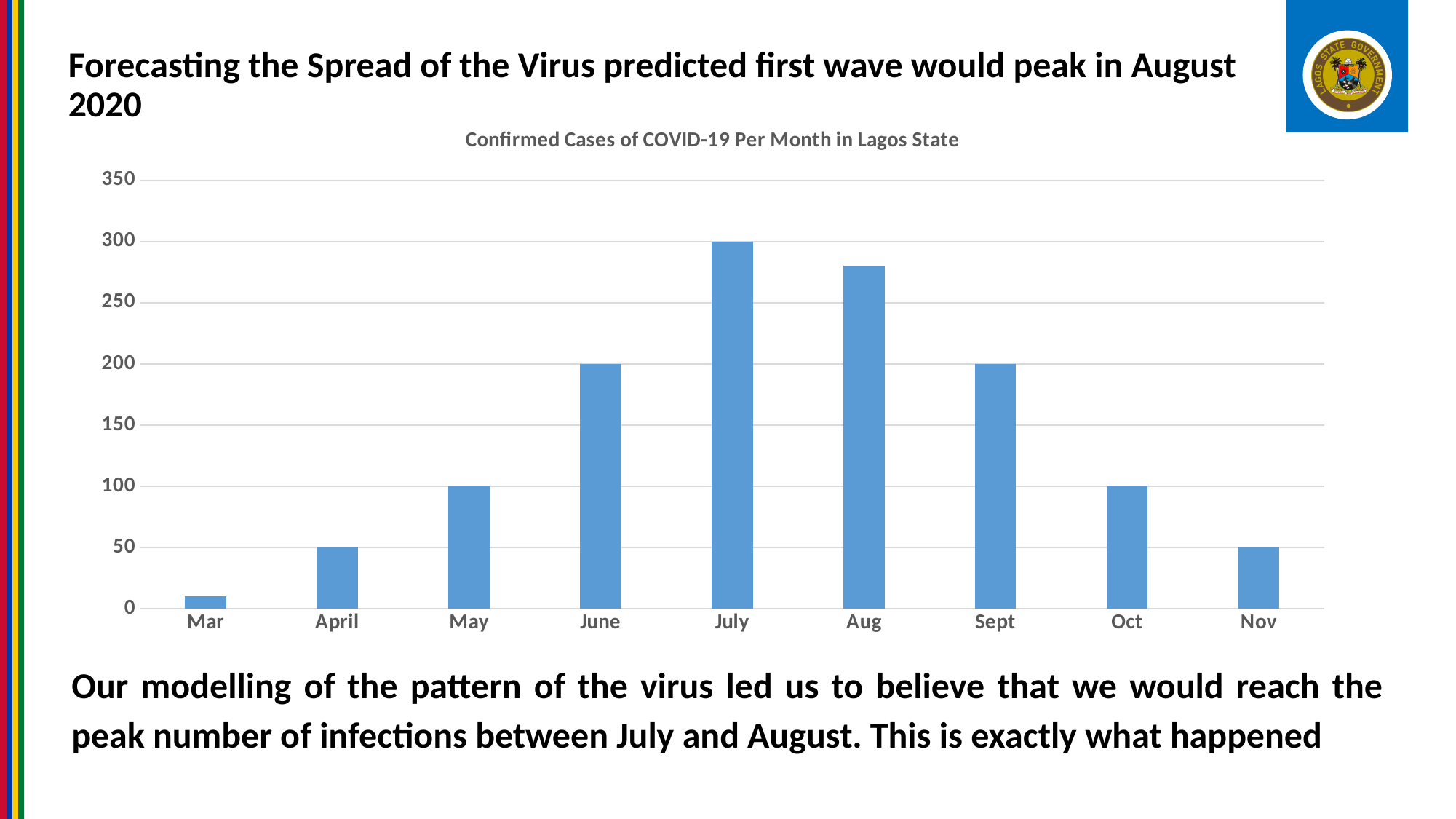
What is the value for Nov? 50 Which month has the lowest number of confirmed cases? Mar What is the title of the chart? Confirmed Cases of COVID-19 Per Month in Lagos State What is the value for June? 200 Which month has the highest number of confirmed cases? July What is the difference between the values for July and June? 100 What is the value for July? 300 How many months are shown on the x axis of the chart? 9 Is the value for Aug greater or less than 250? greater Is the value for Mar greater or less than 50? less Which month has more confirmed cases, July or Aug? July What type of chart is shown on the slide? Bar chart